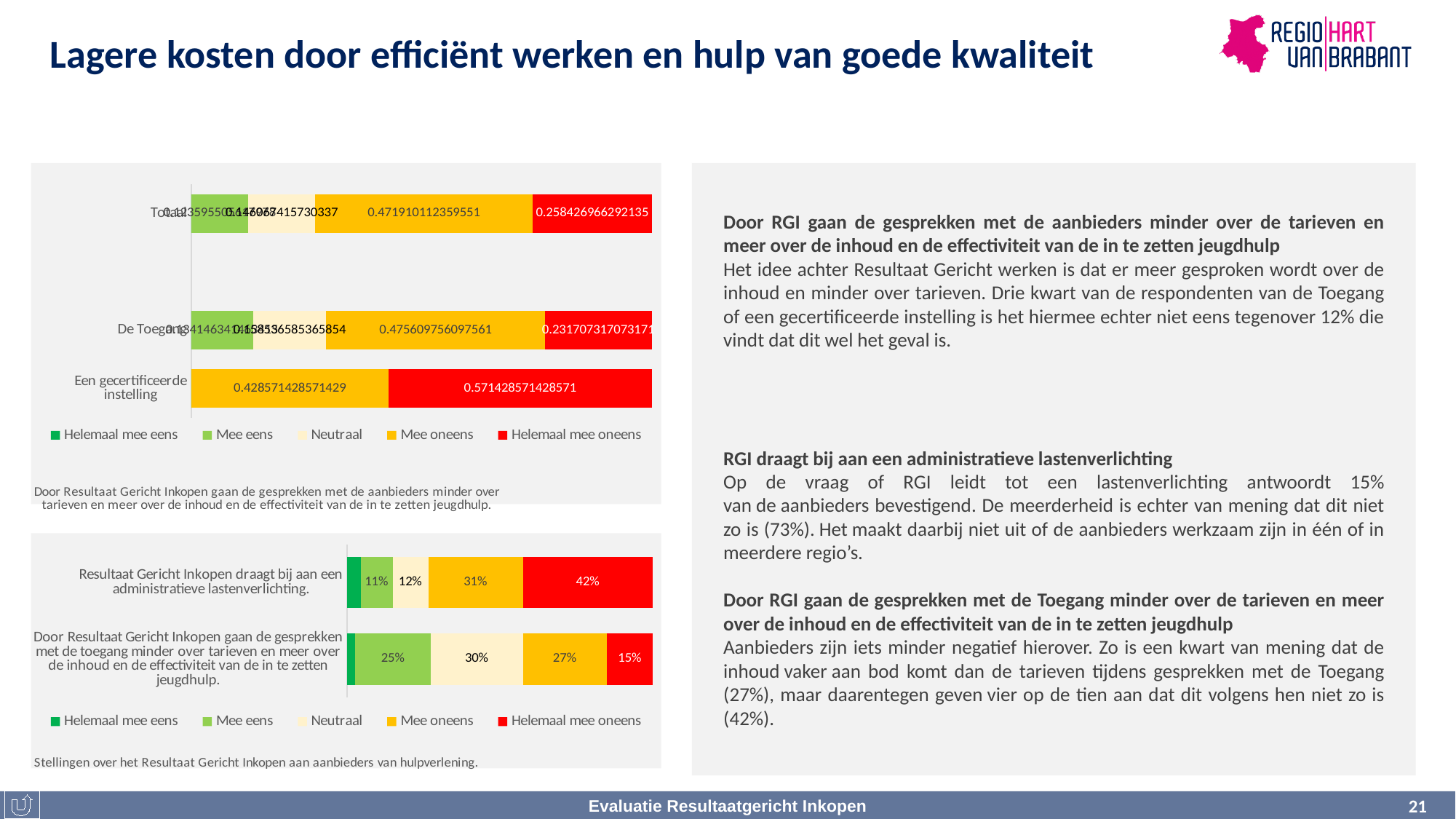
In the bottom chart, what is the difference between the 'Helemaal mee oneens' values of the two statements? 27% How many series does the legend of the bottom chart list? 5 In the bottom chart, which statement has the larger 'Mee eens' share? Door Resultaat Gericht Inkopen gaan de gesprekken met de toegang minder over tarieven en meer over de inhoud en de effectiviteit van de in te zetten jeugdhulp. In the bottom chart, what is the 'Mee oneens' value for 'Resultaat Gericht Inkopen draagt bij aan een administratieve lastenverlichting.'? 31% In the bottom chart, what is the 'Neutraal' value for the statement about gesprekken met de toegang? 30% How many categories are shown in the top chart? 3 In the top chart, what is the 'Helemaal mee oneens' value for 'Een gecertificeerde instelling'? 0.571428571428571 In the top chart, which category has the highest 'Helemaal mee oneens' value? Een gecertificeerde instelling In the bottom chart, what is the 'Mee eens' value for the statement about gesprekken met de toegang? 25% What kind of chart is the top chart? Stacked bar chart In the top chart, what is the 'Mee oneens' value for 'De Toegang'? 0.475609756097561 In the bottom chart, what is the 'Helemaal mee oneens' value for 'Resultaat Gericht Inkopen draagt bij aan een administratieve lastenverlichting.'? 42%